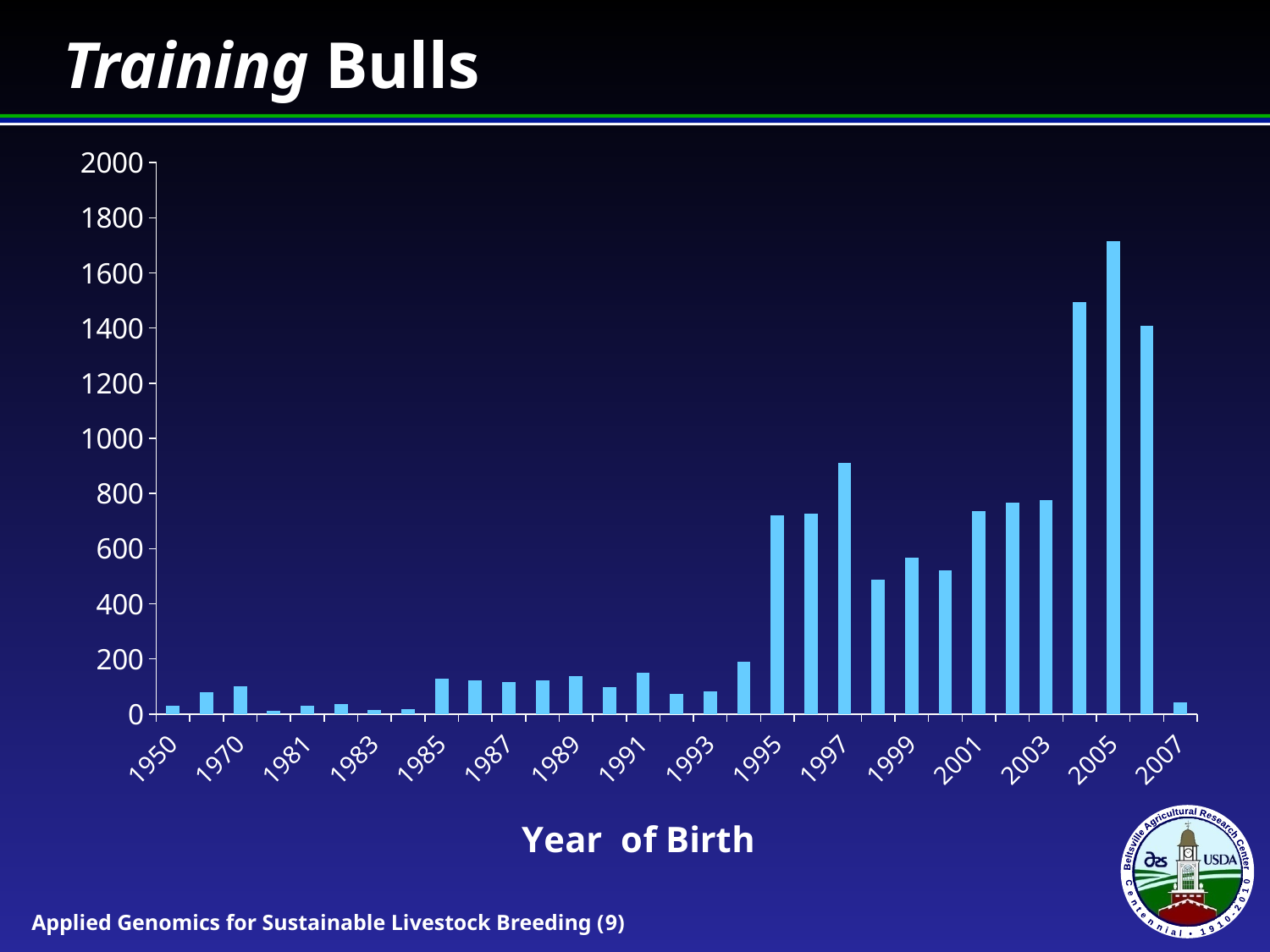
Which is larger, the value for 2005 or the value for 2007? 2005 Which is larger, the value for 1997 or the value for 1995? 1997 Is the value for 2005 greater or less than 1600? greater What is the title of the x axis? Year of Birth What kind of chart is shown on the slide? bar chart What is the highest value shown on the y axis? 2000 Which year of birth has the highest number of training bulls? 2005 Is the value for 1950 greater or less than 200? less Is the value for 1995 greater or less than 600? greater